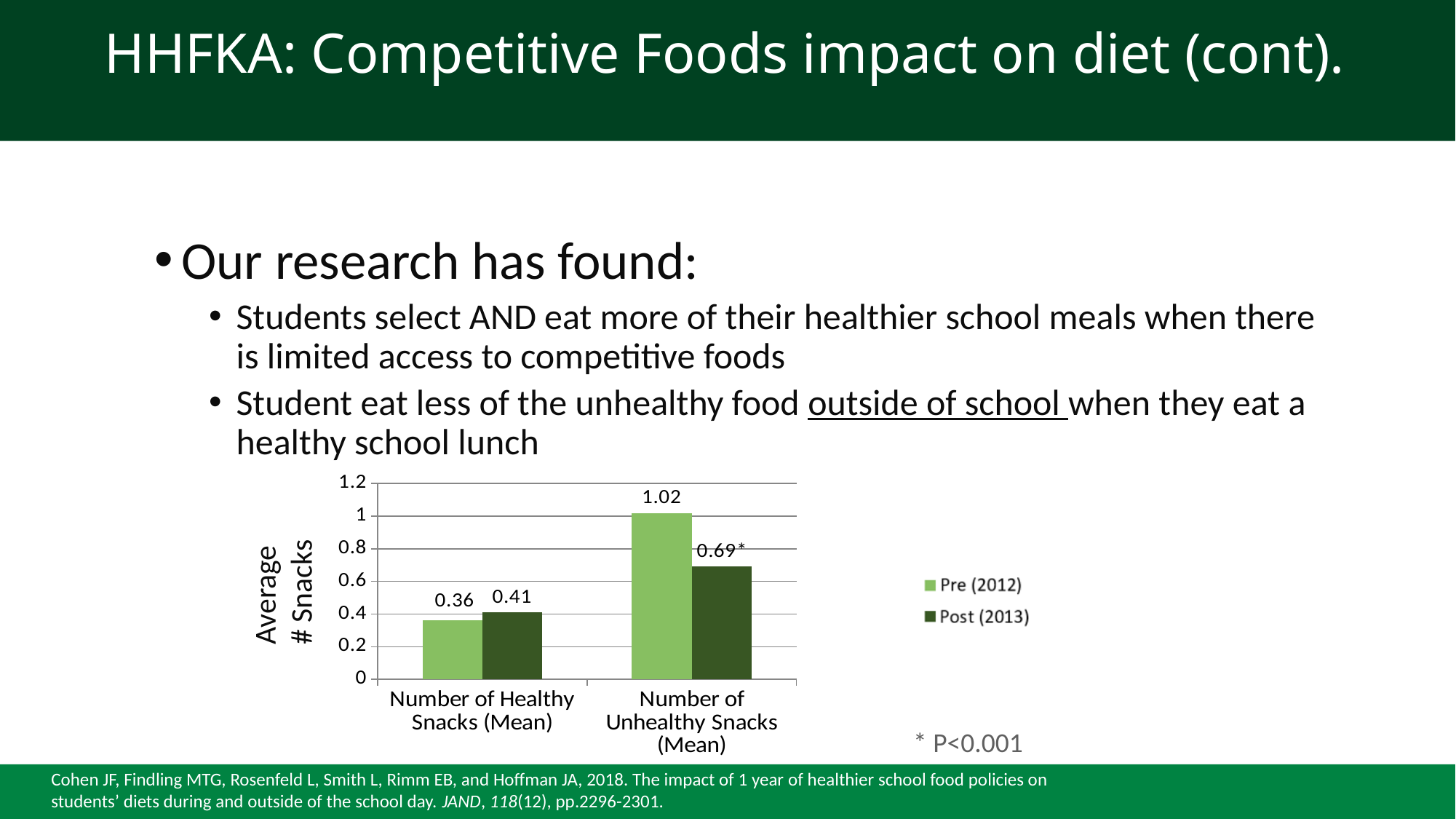
How many series does the chart legend list? 2 What kind of chart is shown on the slide? Bar chart Which bar in the chart has the highest value? Pre (2012), Number of Unhealthy Snacks (Mean) Which bar in the chart has the lowest value? Pre (2012), Number of Healthy Snacks (Mean) Is the Pre (2012) value for Number of Unhealthy Snacks (Mean) greater or less than 1? greater What is the Pre (2012) value for Number of Unhealthy Snacks (Mean)? 1.02 What is the Pre (2012) value for Number of Healthy Snacks (Mean)? 0.36 What is the Post (2013) value for Number of Healthy Snacks (Mean)? 0.41 For Number of Healthy Snacks (Mean), which is larger: Pre (2012) or Post (2013)? Post (2013) What is the Post (2013) value for Number of Unhealthy Snacks (Mean)? 0.69 What is the difference between the Pre (2012) and Post (2013) values for Number of Unhealthy Snacks (Mean)? 0.33 How many categories are shown on the x axis of the chart? 2